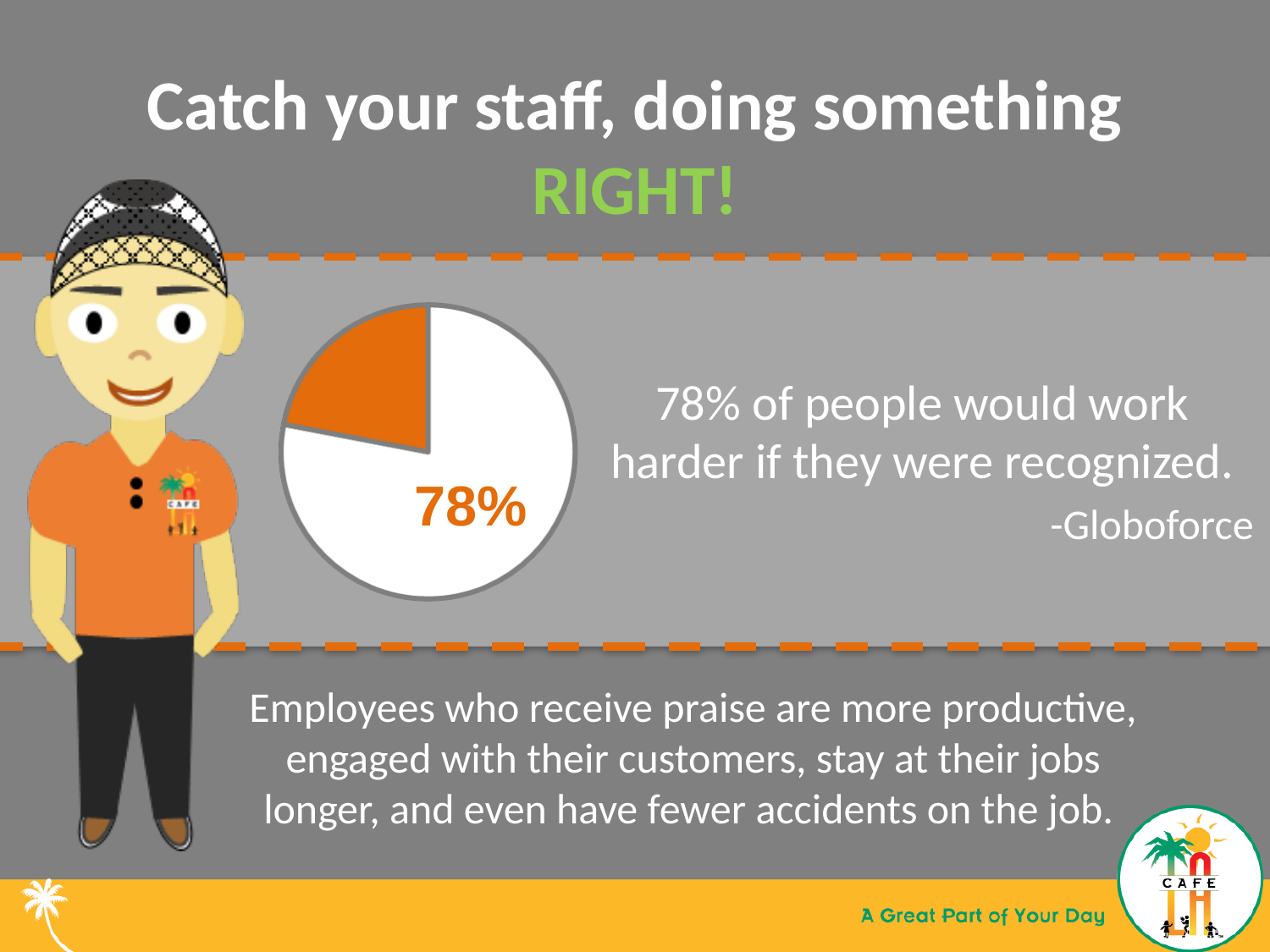
How many slices does the pie chart have? 2 According to the text next to the pie chart, what share of people would work harder if they were recognized? 78% Is the white slice of the pie chart greater or less than 50% of the pie? greater Is the orange slice of the pie chart greater or less than 50% of the pie? less Which slice of the pie chart is the smallest? the orange slice What source is cited for the 78% statistic shown with the pie chart? Globoforce Which slice of the pie chart is larger, the white slice or the orange slice? the white slice What kind of chart is shown on the slide? pie chart What percentage is printed on the pie chart? 78% What colour is the slice of the pie chart labelled 78%? white